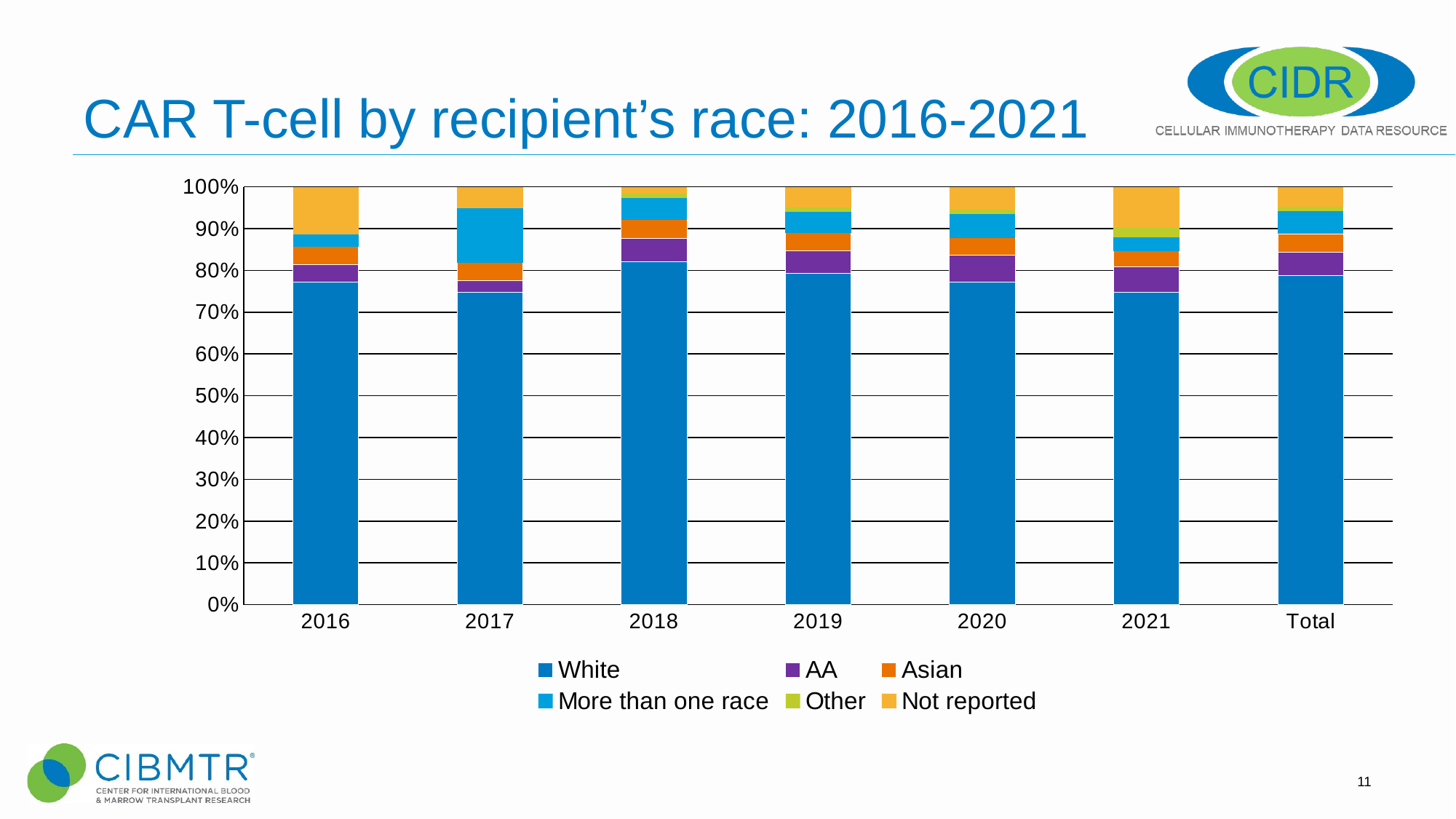
Is the value for White in 2018 greater or less than 70%? greater Is the Not reported share larger in 2016 or in 2018? 2016 Is the value for White in 2016 greater or less than 80%? less What is the title of the chart? CAR T-cell by recipient's race: 2016-2021 Is the value for White in 2017 greater or less than 80%? less What kind of chart is shown on the slide? bar chart Which year has the largest share for White? 2018 How many series does the legend list? 6 How many categories are shown along the x axis? 7 What is the total height of the stacked bar for 2019? 100% Which year has the largest share for More than one race? 2017 Is the White share larger in 2018 or in 2021? 2018